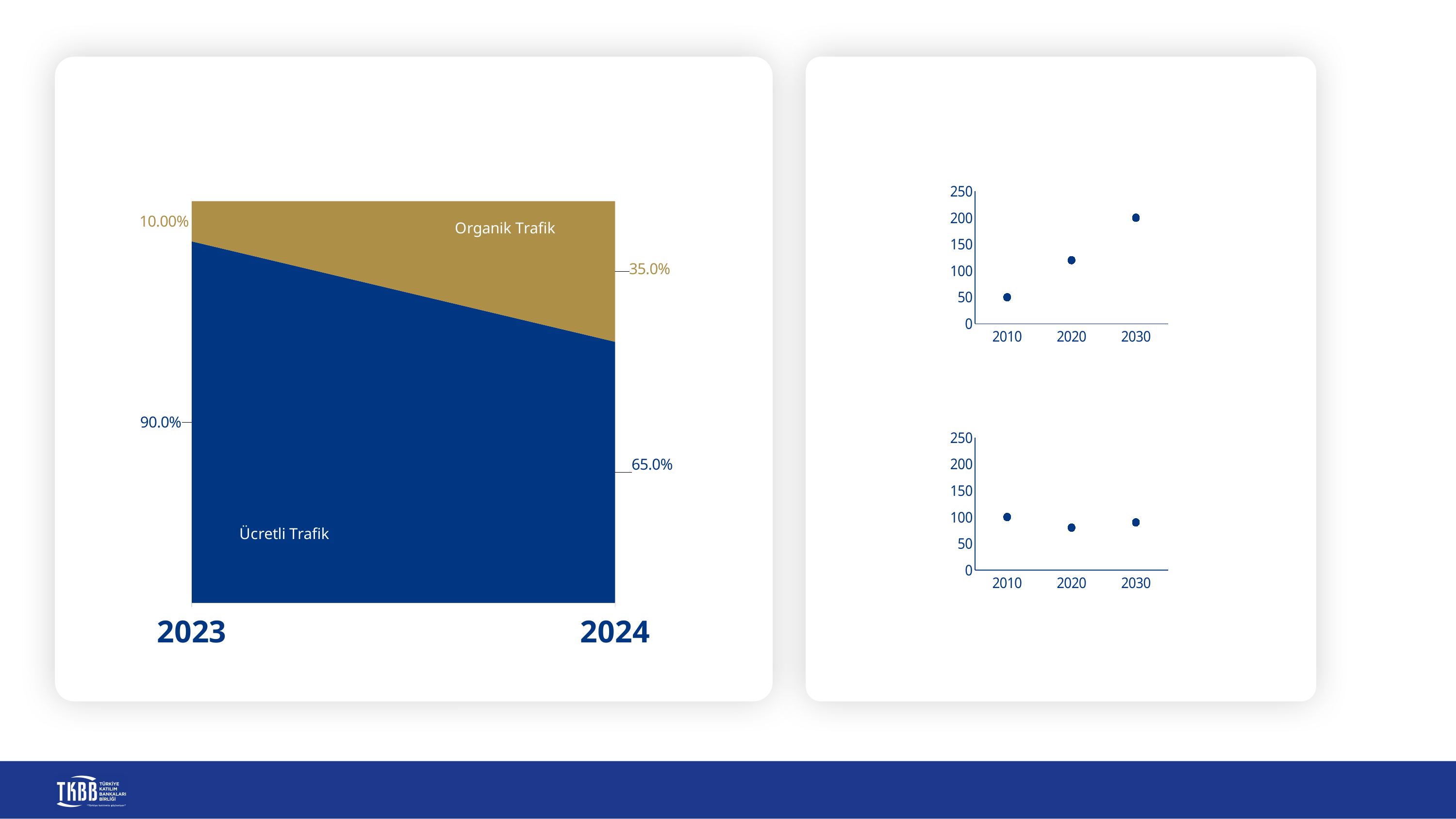
In the top-right chart, is the value for 2020 greater or less than 100? greater In the left chart, by how many percentage points does Ücretli Trafik fall from 2023 to 2024? 25 percentage points In the left chart, what is the value for Ücretli Trafik in 2024? 65.0% In the top-right chart, which year has the highest value? 2030 In the left chart, which series has the larger share in 2024, Organik Trafik or Ücretli Trafik? Ücretli Trafik In the bottom-right chart, which year has the highest value? 2010 In the left chart, what is the value for Organik Trafik in 2023? 10.00% In the bottom-right chart, is the value for 2020 greater or less than 100? less How many data points are plotted in the top-right chart? 3 In the left chart, what is the value for Ücretli Trafik in 2023? 90.0% In the left chart, what is the value for Organik Trafik in 2024? 35.0% In the left chart, does the Organik Trafik share rise or fall from 2023 to 2024? rise